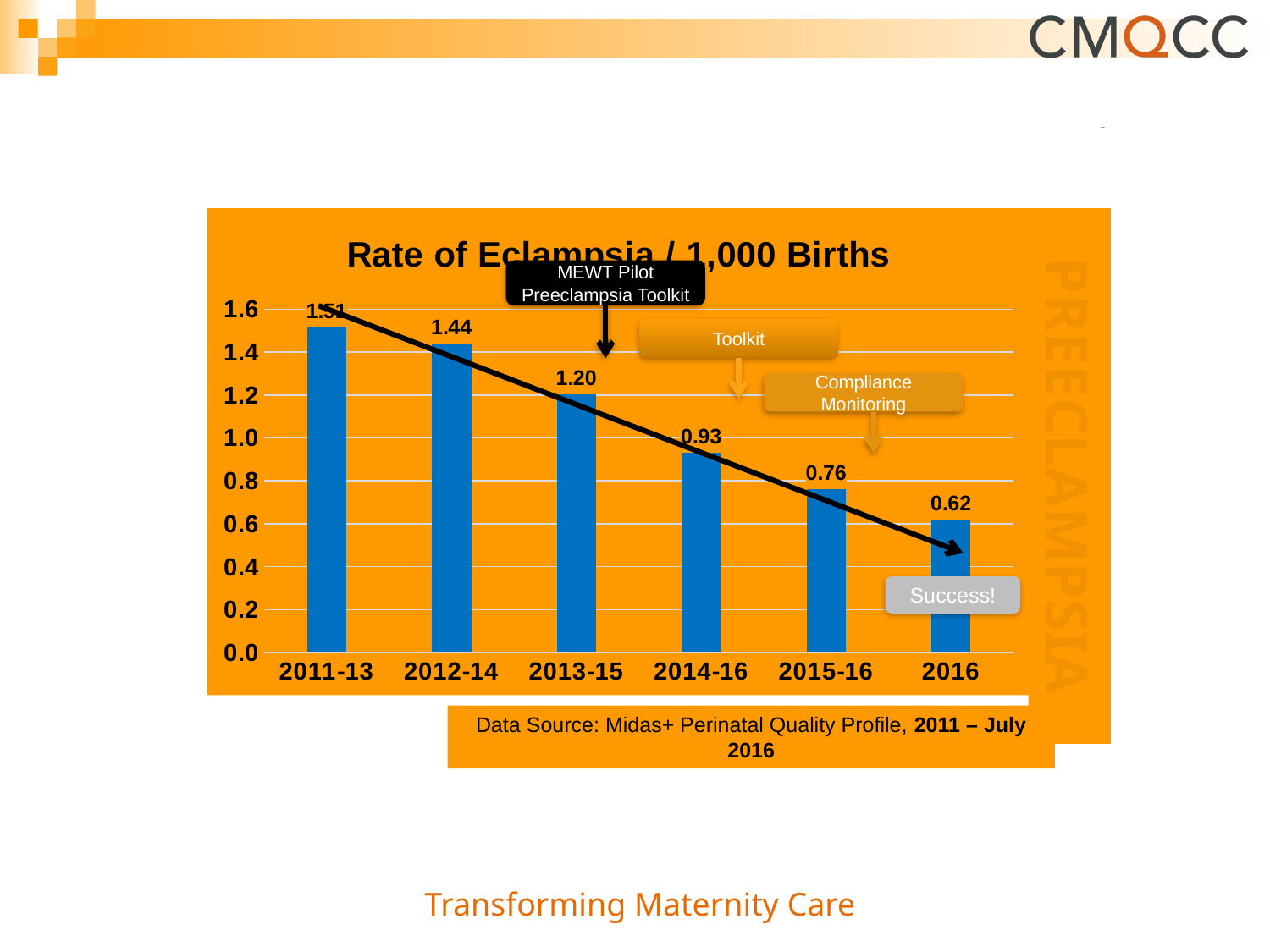
What is the rate of eclampsia per 1,000 births for 2012-14? 1.44 Which has a higher rate of eclampsia, 2014-16 or 2015-16? 2014-16 What is the rate of eclampsia per 1,000 births for 2016? 0.62 What is the title of the chart? Rate of Eclampsia / 1,000 Births How many periods are shown on the x axis of the chart? 6 What type of chart is shown on the slide? bar chart What is the rate of eclampsia per 1,000 births for 2014-16? 0.93 What is the rate of eclampsia per 1,000 births for 2013-15? 1.20 Which period has the highest rate of eclampsia? 2011-13 Which period has the lowest rate of eclampsia? 2016 What is the difference between the rates for 2013-15 and 2015-16? 0.44 Do the rates of eclampsia rise or fall from 2011-13 to 2016? fall